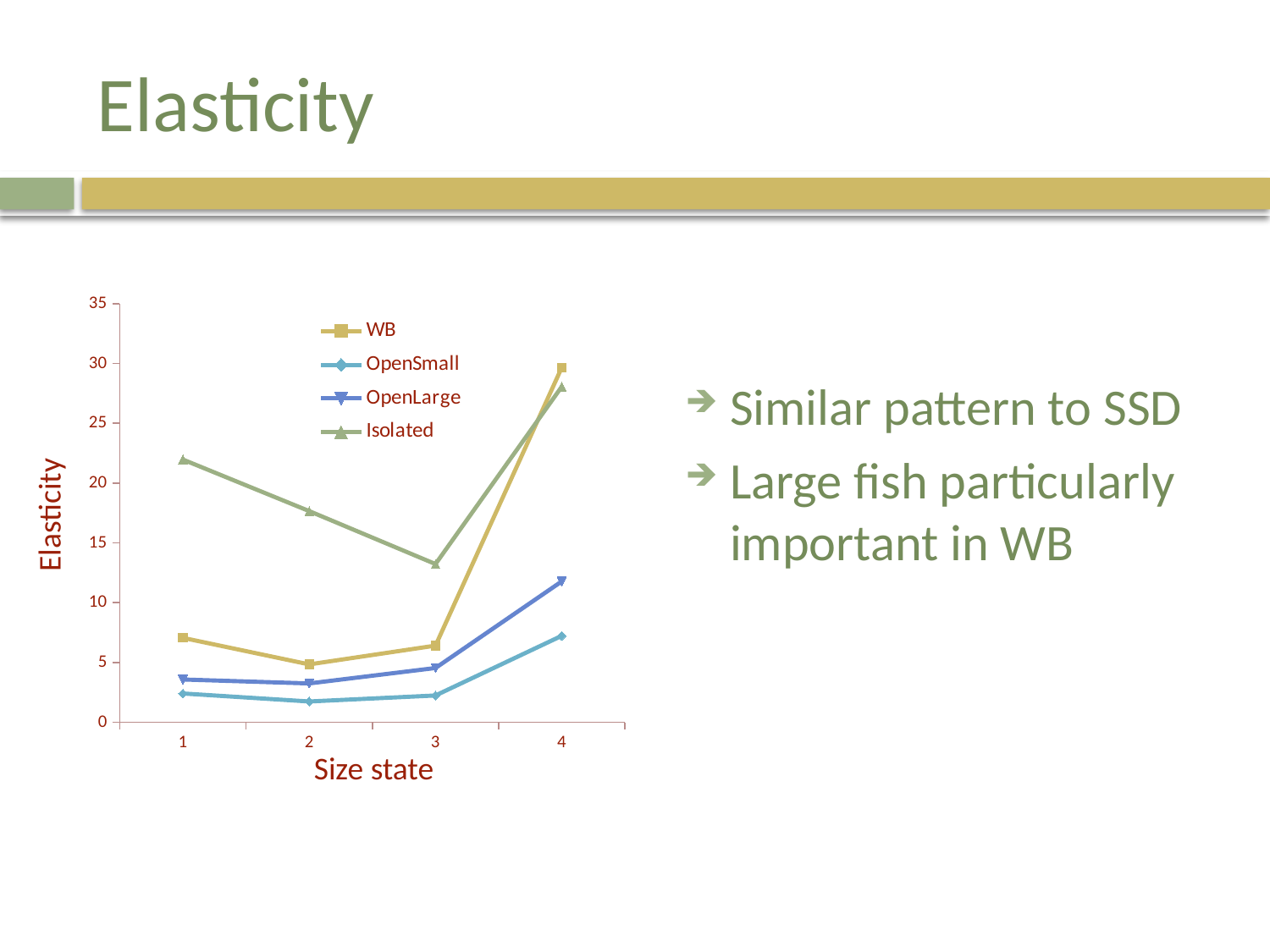
Is the elasticity for Isolated at size state 1 greater or less than 20? greater How many series does the legend list? 4 How many size states are plotted along the x axis? 4 Is the elasticity for OpenSmall at size state 4 greater or less than 10? less What is the title of the x axis of the chart? Size state Which series has the lowest elasticity at size state 4? OpenSmall Is the elasticity for WB at size state 4 greater or less than 25? greater Does the Isolated series rise or fall from size state 1 to size state 3? Falls At size state 1, which series has the higher elasticity, Isolated or WB? Isolated What kind of chart is shown on the slide? Line chart At which size state does the Isolated series reach its lowest elasticity? 3 At which size state does the WB series reach its highest elasticity? 4